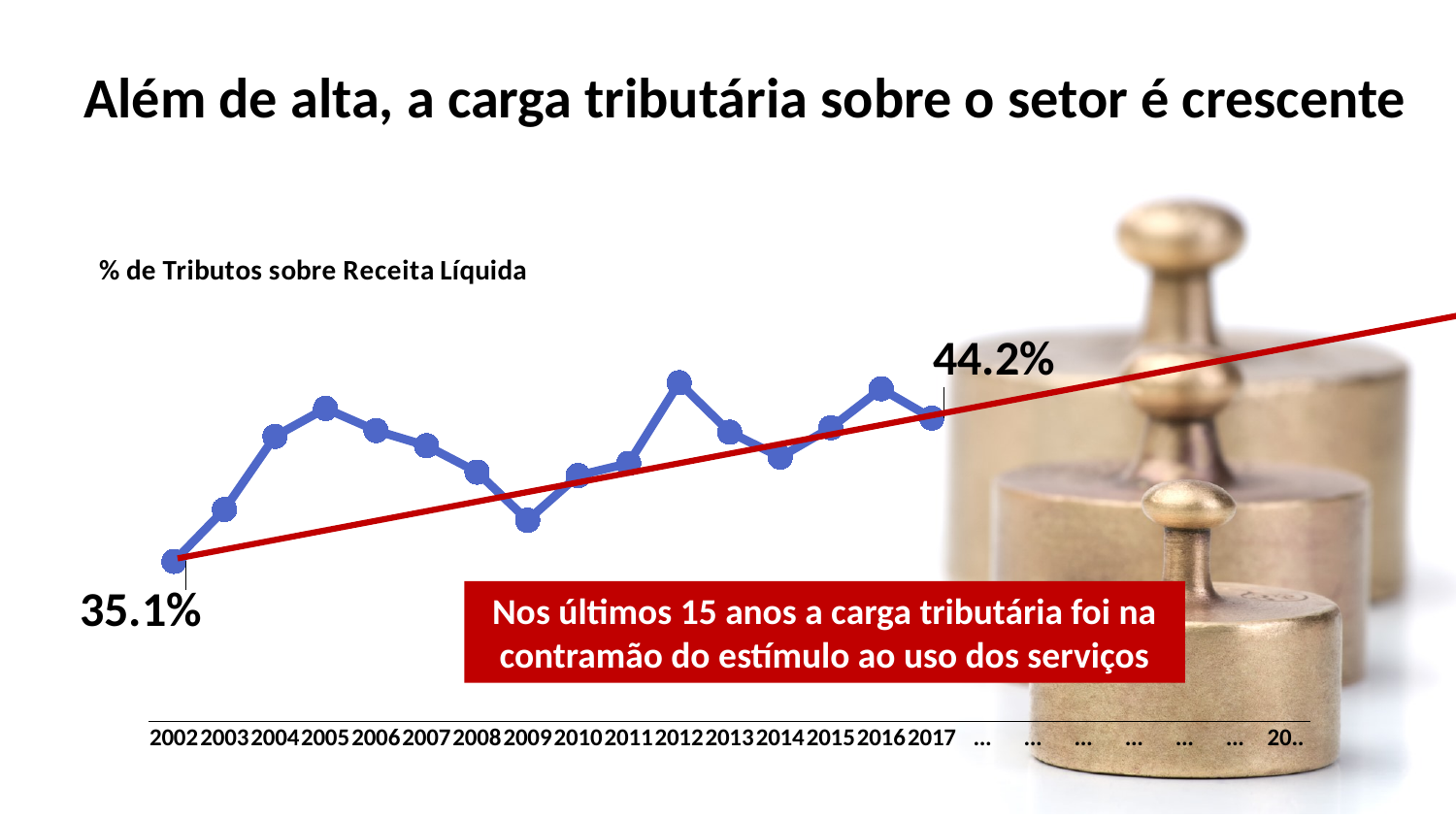
What kind of chart is shown on the slide? Line chart Which is larger, the value for 2002 or the value for 2017? 2017 Which is higher, the value for 2009 or the value for 2002? 2009 What colour is the straight trend line drawn across the chart? Red How many years with data points are plotted on the chart? 16 What is the value shown for 2002? 35.1% Which year has the lowest value on the chart? 2002 What is the value shown for 2017? 44.2% What is the difference between the 2017 value and the 2002 value? 9.1 percentage points Overall, do the values rise or fall from 2002 to 2017? Rise What is the title of the chart? % de Tributos sobre Receita Líquida Which is higher, the value for 2005 or the value for 2009? 2005